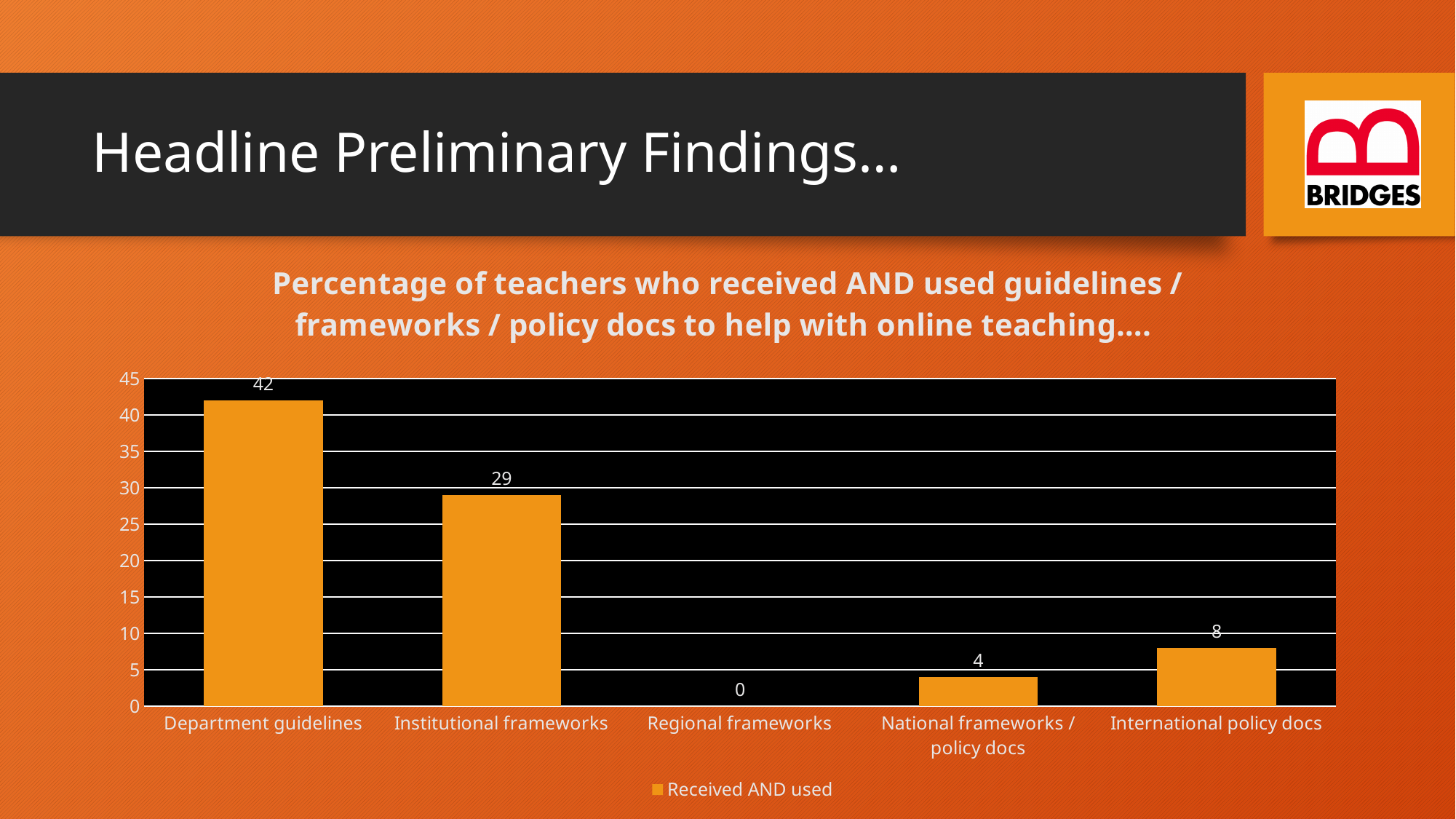
What is the value for International policy docs? 8 What series name does the legend show? Received AND used What is the value for Department guidelines? 42 What kind of chart is shown on the slide? Bar chart What is the value for National frameworks / policy docs? 4 What is the difference between the values for Department guidelines and Institutional frameworks? 13 Which category has the lowest value? Regional frameworks How many categories are shown on the x axis? 5 Which category has the highest value? Department guidelines What is the value for Institutional frameworks? 29 What is the value for Regional frameworks? 0 Which is larger, the value for International policy docs or the value for National frameworks / policy docs? International policy docs